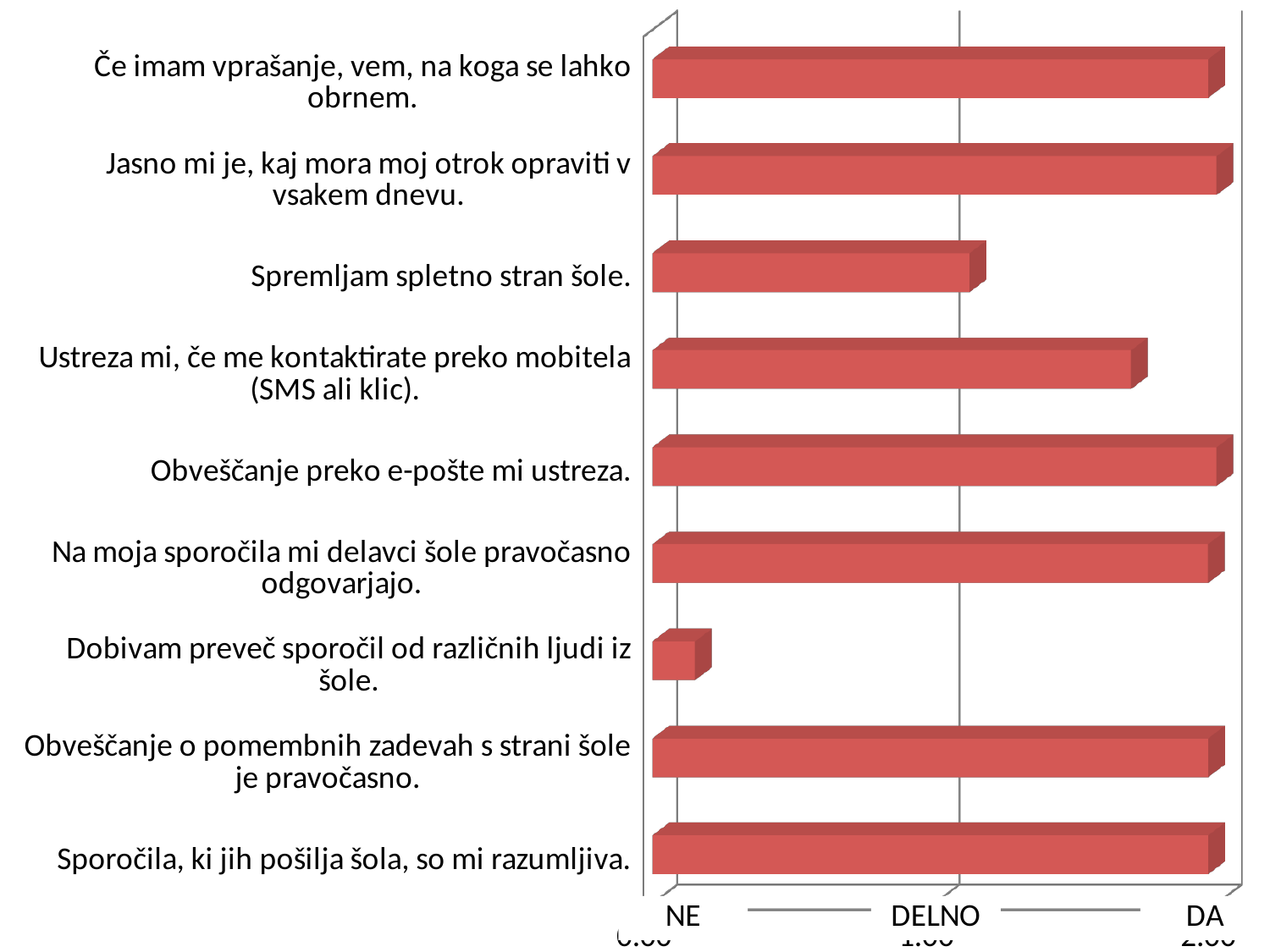
What colour are the bars in the chart? red Is the value for "Ustreza mi, če me kontaktirate preko mobitela (SMS ali klic)." greater or less than 1.00? greater Which has the larger value: "Spremljam spletno stran šole." or "Če imam vprašanje, vem, na koga se lahko obrnem."? Če imam vprašanje, vem, na koga se lahko obrnem. Which has the larger value: "Spremljam spletno stran šole." or "Ustreza mi, če me kontaktirate preko mobitela (SMS ali klic)."? Ustreza mi, če me kontaktirate preko mobitela (SMS ali klic). Which statement has the lowest value in the chart? Dobivam preveč sporočil od različnih ljudi iz šole. What kind of chart is shown on the slide? bar chart Is the value for "Sporočila, ki jih pošilja šola, so mi razumljiva." greater or less than 1.00? greater Which has the larger value: "Dobivam preveč sporočil od različnih ljudi iz šole." or "Obveščanje o pomembnih zadevah s strani šole je pravočasno."? Obveščanje o pomembnih zadevah s strani šole je pravočasno. What are the three text labels shown on the horizontal axis? NE, DELNO, DA Is the value for "Dobivam preveč sporočil od različnih ljudi iz šole." greater or less than 1.00? less How many categories (statements) are plotted in the chart? 9